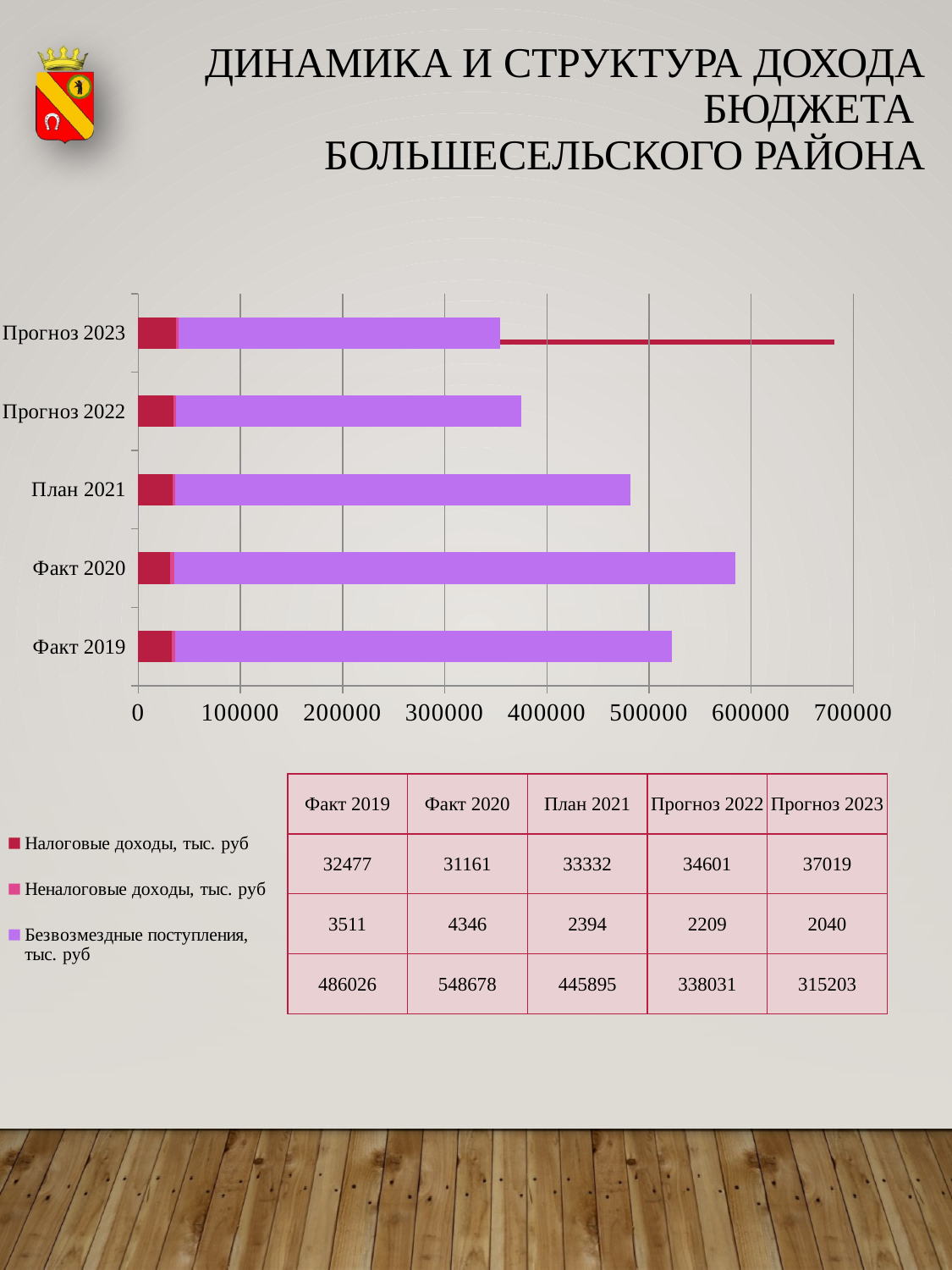
What is the value of Безвозмездные поступления, тыс. руб for Прогноз 2022? 338031 How many series does the legend list? 3 Which category has the highest value of Безвозмездные поступления, тыс. руб? Факт 2020 Is the total length of the Факт 2020 bar greater or less than 500000? greater How many categories are shown on the chart? 5 Which is larger: Безвозмездные поступления, тыс. руб for Факт 2019 or for План 2021? Факт 2019 What is the total of the stacked bar for Факт 2019? 522014 Do the values of Безвозмездные поступления, тыс. руб rise or fall from Факт 2020 to Прогноз 2023? fall What is the difference between Налоговые доходы, тыс. руб for Прогноз 2023 and for Факт 2019? 4542 What is the value of Налоговые доходы, тыс. руб for Факт 2020? 31161 What kind of chart is shown on the slide? bar chart Which category has the lowest value of Неналоговые доходы, тыс. руб? Прогноз 2023